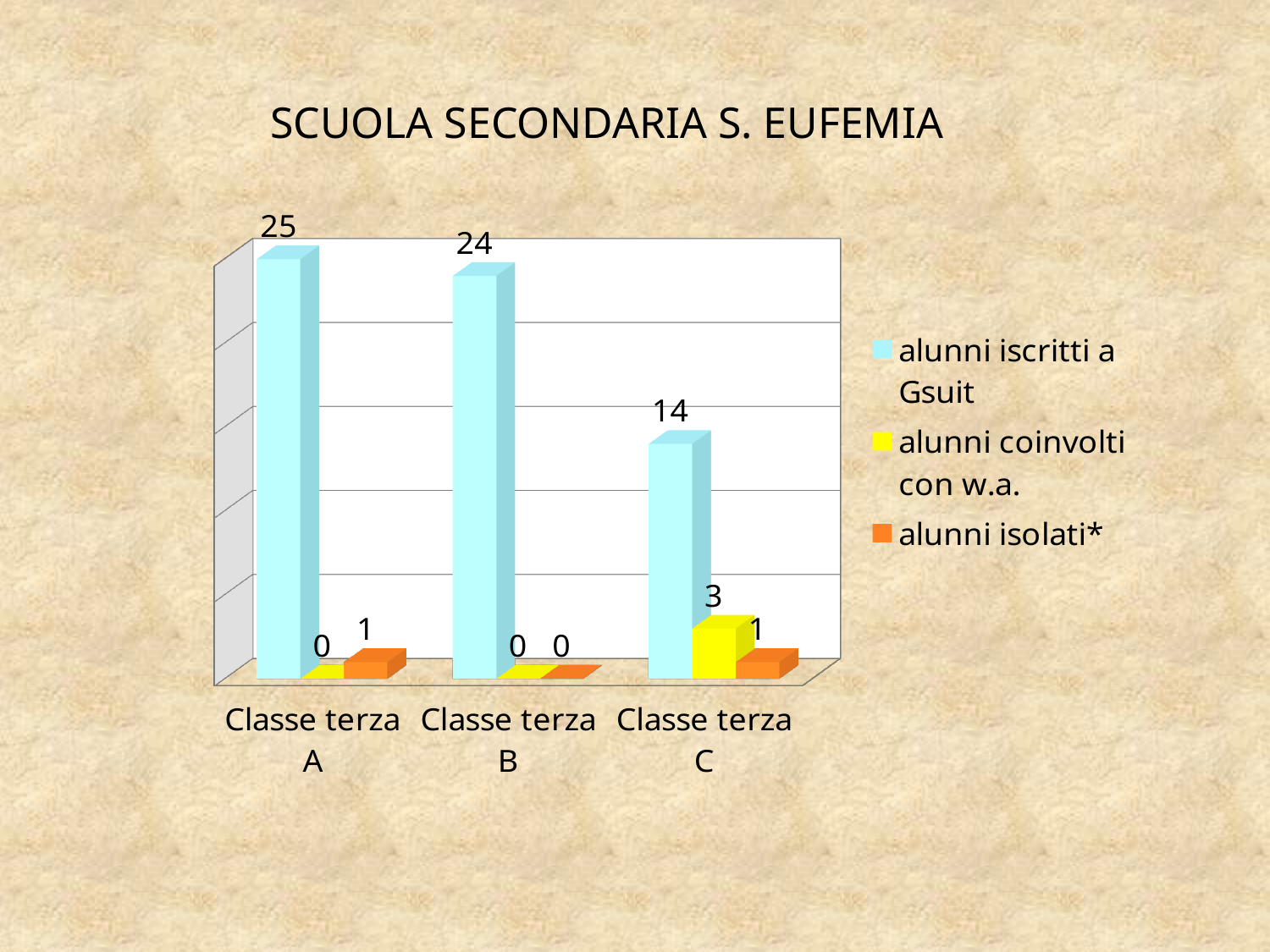
How many series does the legend list? 3 What is the difference between 'alunni iscritti a Gsuit' for Classe terza A and Classe terza C? 11 How many classes are shown on the x axis? 3 What kind of chart is shown on the slide? Bar chart What is the title of the slide? SCUOLA SECONDARIA S. EUFEMIA What is the value of 'alunni iscritti a Gsuit' for Classe terza A? 25 Which class has the lowest value for 'alunni iscritti a Gsuit'? Classe terza C What is the value of 'alunni isolati*' for Classe terza B? 0 What is the value of 'alunni iscritti a Gsuit' for Classe terza C? 14 Which class has the highest value for 'alunni iscritti a Gsuit'? Classe terza A What is the value of 'alunni coinvolti con w.a.' for Classe terza C? 3 Which is larger: 'alunni iscritti a Gsuit' for Classe terza B or for Classe terza C? Classe terza B